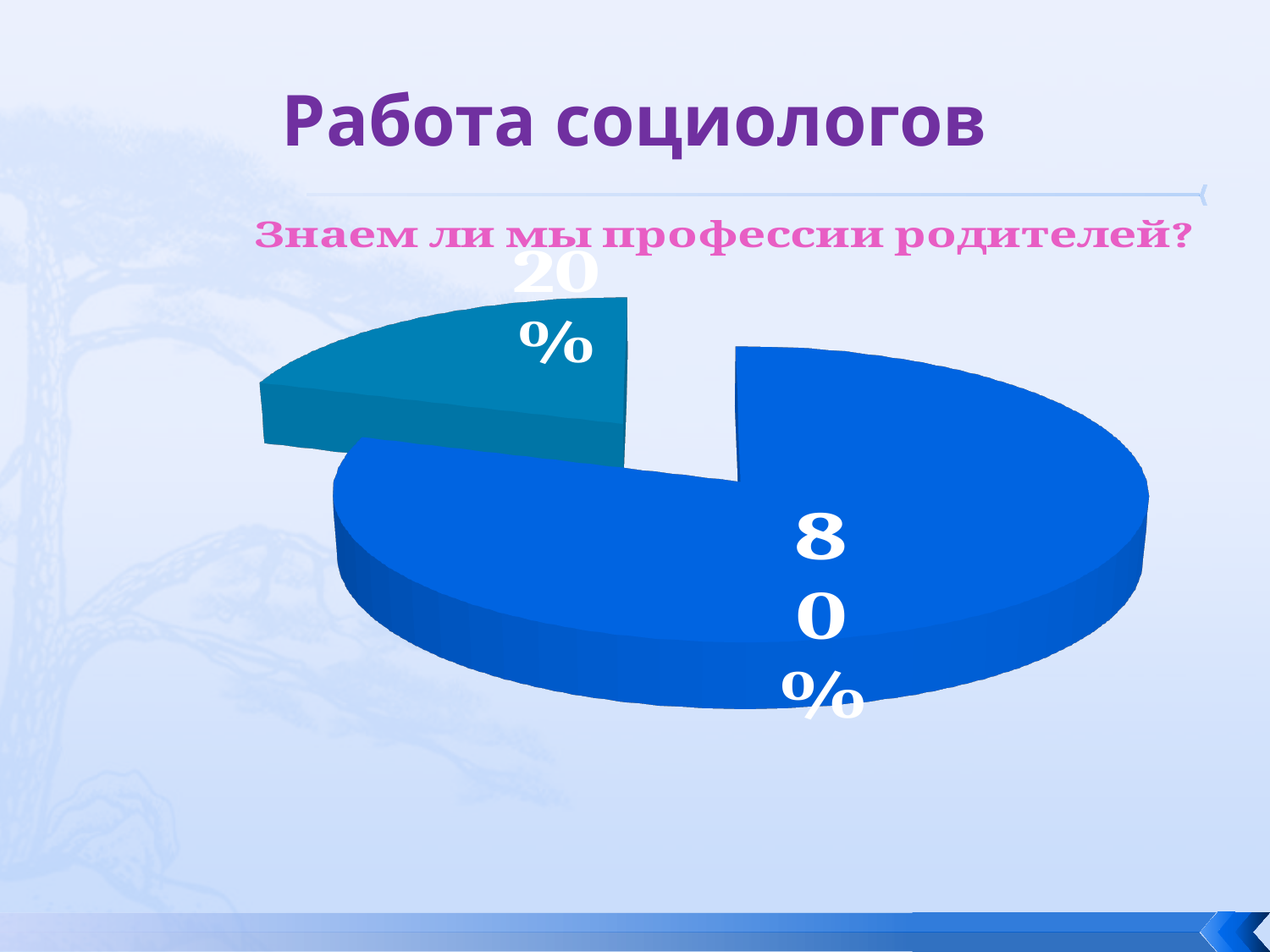
What percentage is shown on the large dark blue slice of the pie chart? 80% Which is larger: the dark blue slice or the teal slice? the dark blue slice What is the difference in percentage points between the two slices of the pie chart? 60 What is the chart's title? Знаем ли мы профессии родителей? How many slices does the pie chart have? 2 What kind of chart is shown on the slide? pie chart What percentage is shown on the small teal slice of the pie chart? 20% Which slice of the pie chart is the largest? the dark blue slice (80%) What is the total of the two slice values shown on the pie chart? 100% Which slice of the pie chart is the smallest? the teal slice (20%) Which slice of the pie chart is pulled out (exploded) from the rest of the pie? the teal 20% slice